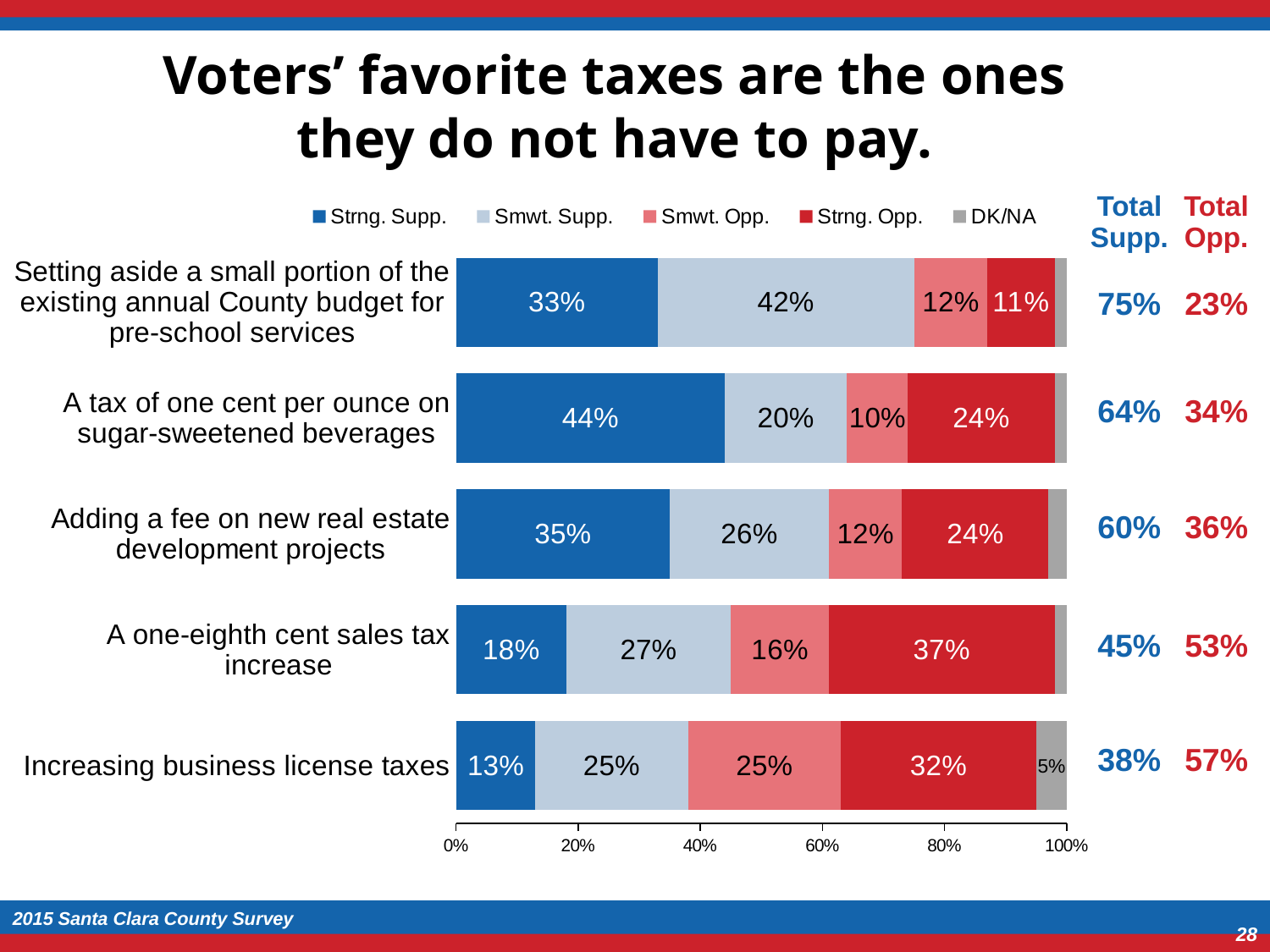
What is the Strng. Opp. value for a one-eighth cent sales tax increase? 37% How many series does the legend list? 5 What is the Smwt. Supp. value for setting aside a small portion of the existing annual County budget for pre-school services? 42% Which proposal has the lowest Strng. Supp. value? Increasing business license taxes Which proposal has the highest Strng. Supp. value? A tax of one cent per ounce on sugar-sweetened beverages What is the difference in Strng. Opp. between a one-eighth cent sales tax increase and increasing business license taxes? 5 percentage points What percentage of voters strongly support a tax of one cent per ounce on sugar-sweetened beverages? 44% What is the DK/NA value for increasing business license taxes? 5% Which has a larger Smwt. Supp. value: the pre-school services proposal or the fee on new real estate development projects? The pre-school services proposal What is the Total Supp. value shown for adding a fee on new real estate development projects? 60% How many tax proposals are shown in the chart? 5 What type of chart is shown on the slide? Stacked bar chart